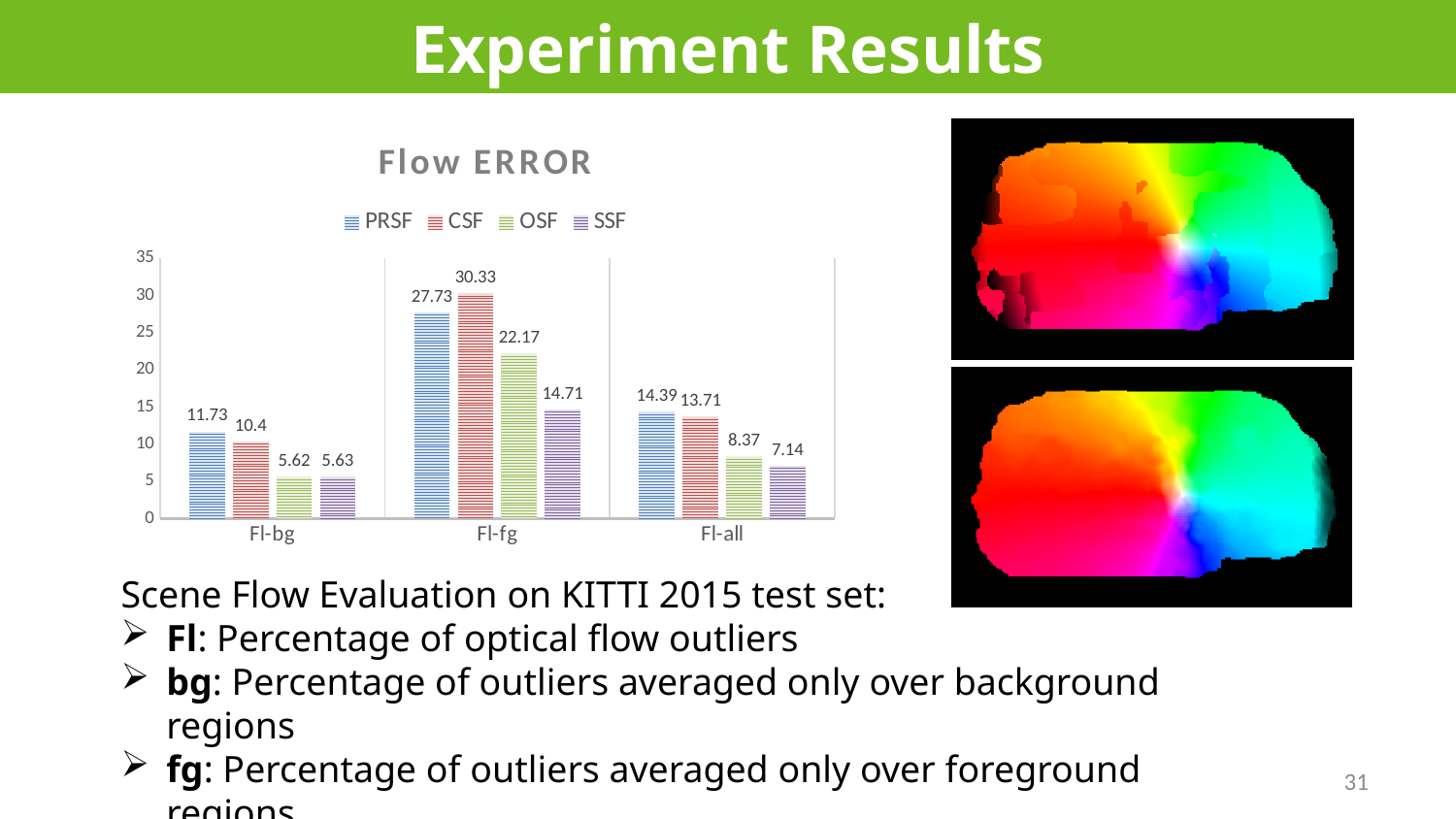
What is the title of the chart? Flow ERROR Which series has the lowest value in the Fl-all category? SSF How many categories are shown on the x axis? 3 Which series has the highest value in the Fl-fg category? CSF What is the value for OSF in the Fl-bg category? 5.62 What is the value for SSF in the Fl-all category? 7.14 How many series does the legend list? 4 What kind of chart is shown on the slide? bar chart What is the difference between the PRSF and SSF values in the Fl-fg category? 13.02 Which is larger in the Fl-all category, PRSF or CSF? PRSF What is the value for CSF in the Fl-fg category? 30.33 Is the value for OSF in the Fl-fg category greater or less than 20? greater